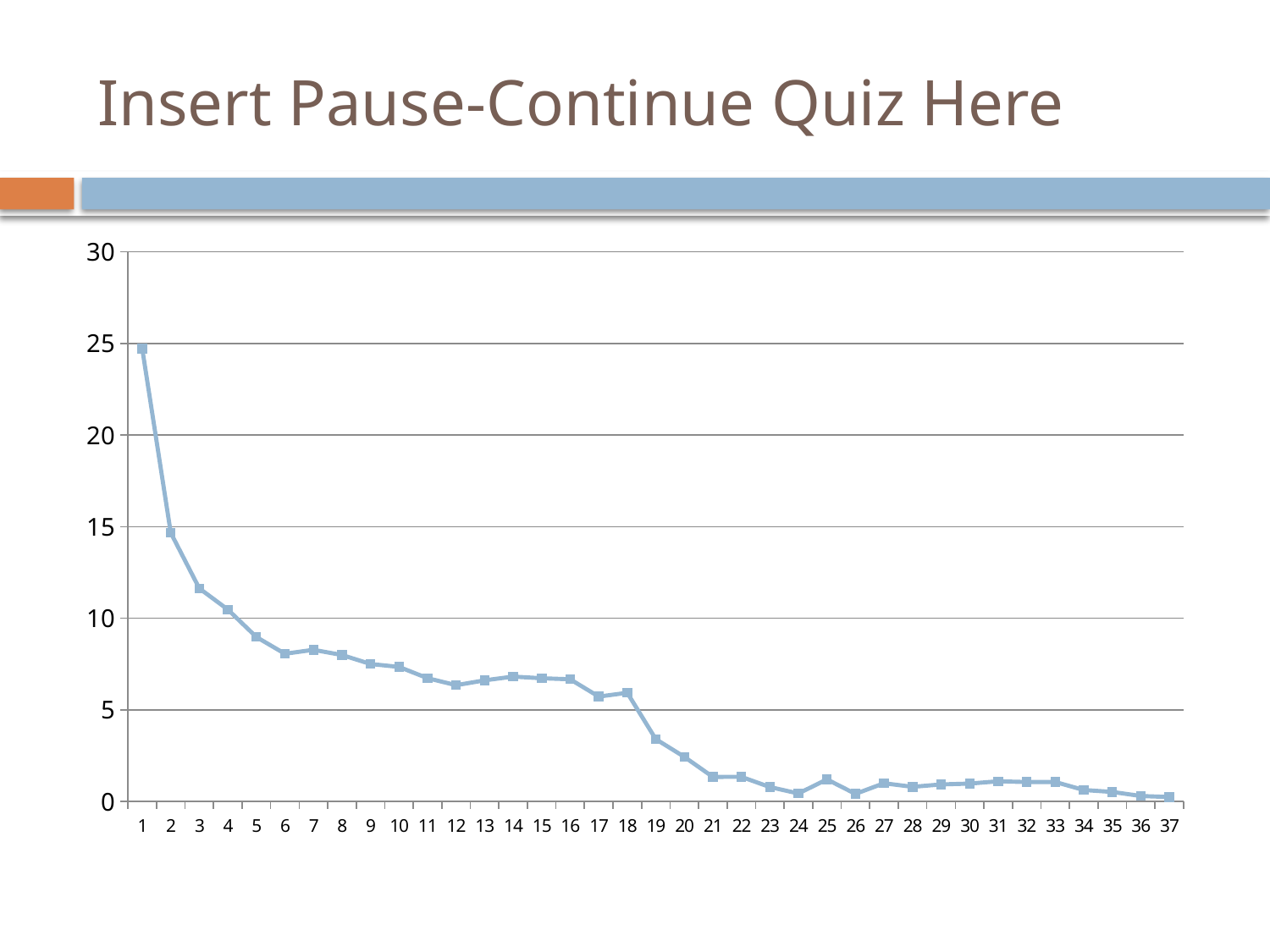
Is the value at x = 3 greater or less than 10? greater Is the value at x = 2 greater or less than 10? greater Which x-axis category has the highest value? 1 What kind of chart is shown on the slide? line chart Is the value at x = 5 greater or less than 10? less Which is larger, the value at x = 18 or the value at x = 19? x = 18 Which is larger, the value at x = 1 or the value at x = 2? x = 1 How many points are plotted along the x axis? 37 Do the values generally rise or fall from left to right along the x axis? fall